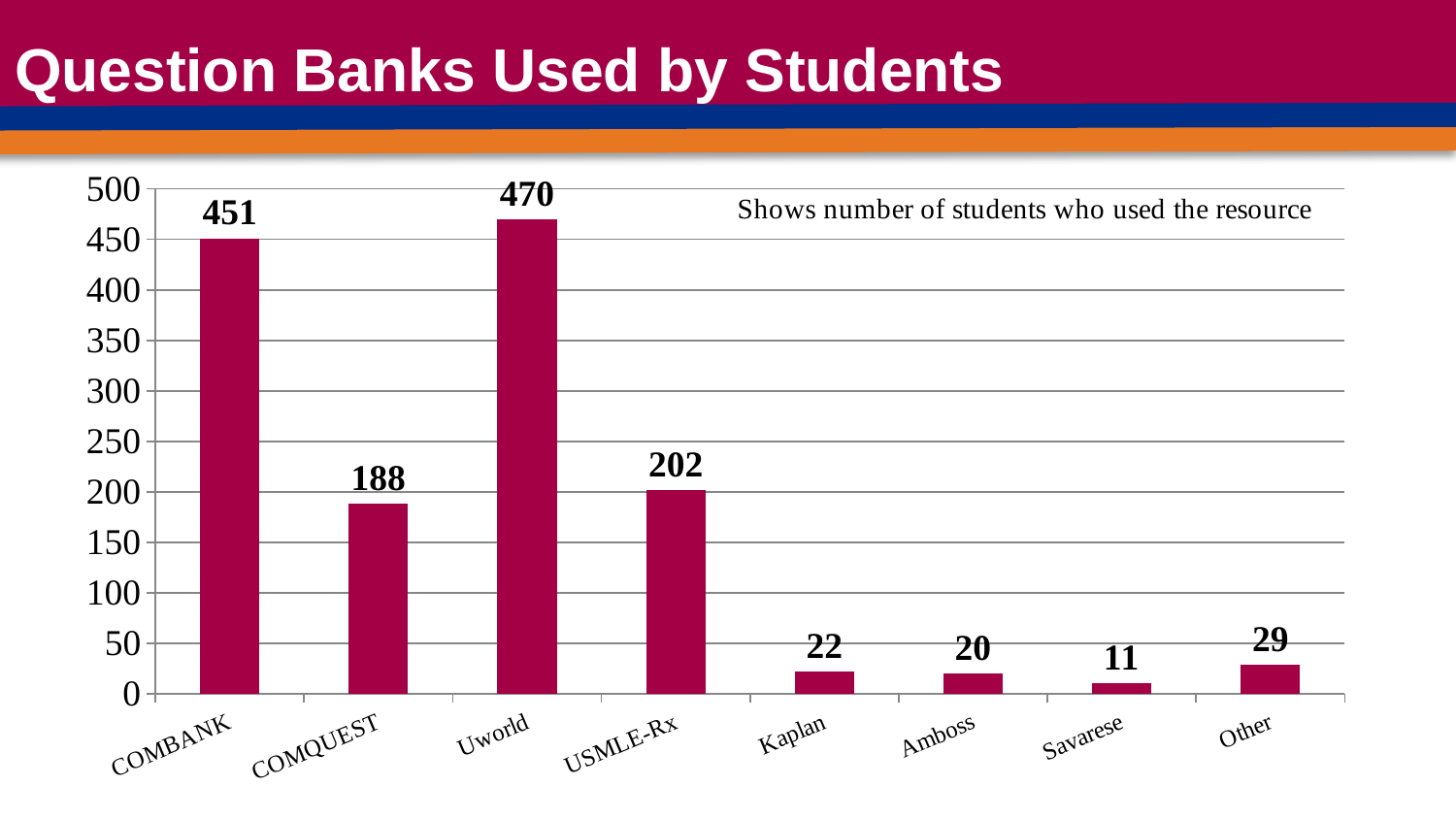
Which question bank was used by the most students? Uworld Which was used by more students, Kaplan or Amboss? Kaplan Which question bank was used by the fewest students? Savarese How many question banks are shown on the x axis? 8 What is the difference between the number of students who used Uworld and the number who used COMBANK? 19 Is the value for COMQUEST greater or less than 200? less How many students used COMBANK? 451 What is the title of the slide containing the chart? Question Banks Used by Students How many students used Savarese? 11 What is the difference between the values for USMLE-Rx and COMQUEST? 14 What is the value shown for USMLE-Rx? 202 What type of chart is shown on the slide? bar chart